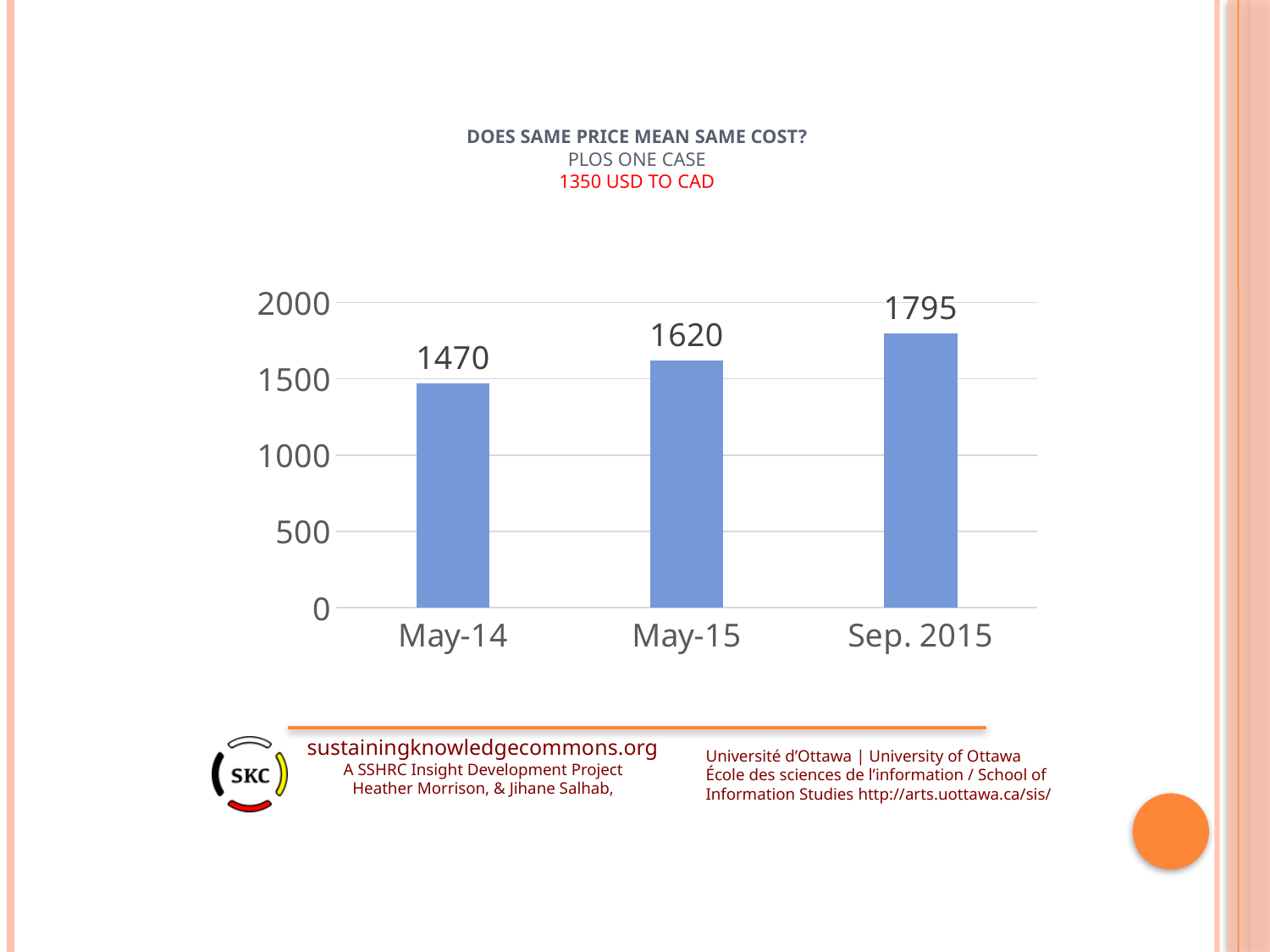
Which category has the highest value? Sep. 2015 What is the difference between the values for Sep. 2015 and May-14? 325 What is the value for Sep. 2015? 1795 What is the value for May-15? 1620 What kind of chart is shown on the slide? bar chart Which is larger, the value for May-15 or the value for Sep. 2015? Sep. 2015 Do the values rise or fall from May-14 to Sep. 2015? rise What is the value for May-14? 1470 What is the difference between the values for May-15 and May-14? 150 Is the value for May-14 greater or less than 1500? less Which category has the lowest value? May-14 How many categories are shown on the x axis? 3